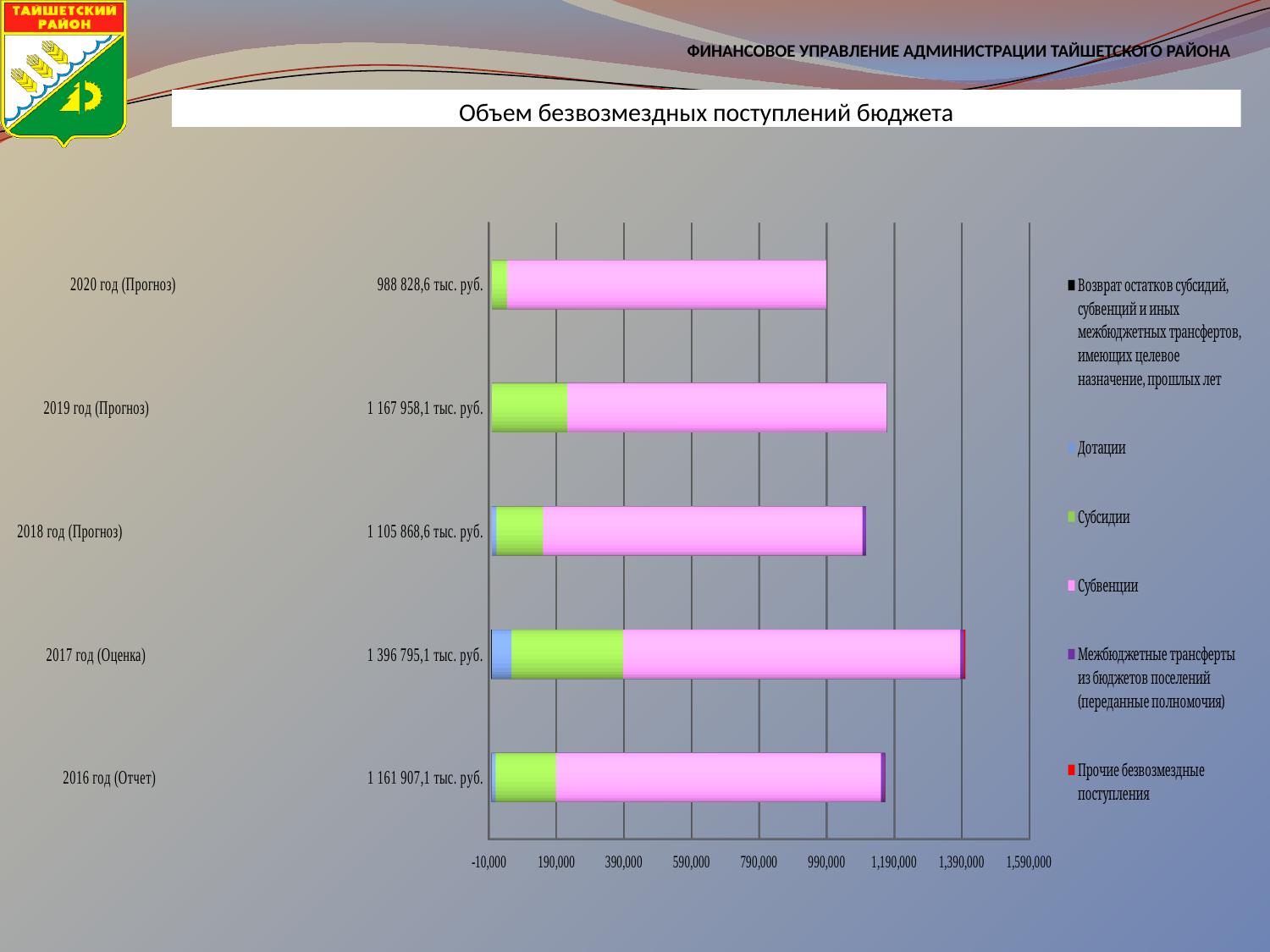
Which year has the lowest total volume of gratuitous receipts? 2020 год (Прогноз) What kind of chart is shown on the slide? Stacked horizontal bar chart How many series does the legend list? 6 Is the Субсидии segment for 2020 год (Прогноз) greater or less than 190,000? less What value is shown for 2016 год (Отчет)? 1 161 907,1 тыс. руб. What is the difference between the totals for 2019 год (Прогноз) and 2018 год (Прогноз)? 62 089,5 тыс. руб. Which year has the highest total volume of gratuitous receipts? 2017 год (Оценка) How many years (categories) are shown on the chart? 5 What is the total volume of gratuitous budget receipts shown for 2017 год (Оценка)? 1 396 795,1 тыс. руб. Which is larger, the total for 2019 год (Прогноз) or for 2016 год (Отчет)? 2019 год (Прогноз) What is the difference between the totals for 2017 год (Оценка) and 2016 год (Отчет)? 234 888,0 тыс. руб. What value is shown for 2020 год (Прогноз)? 988 828,6 тыс. руб.